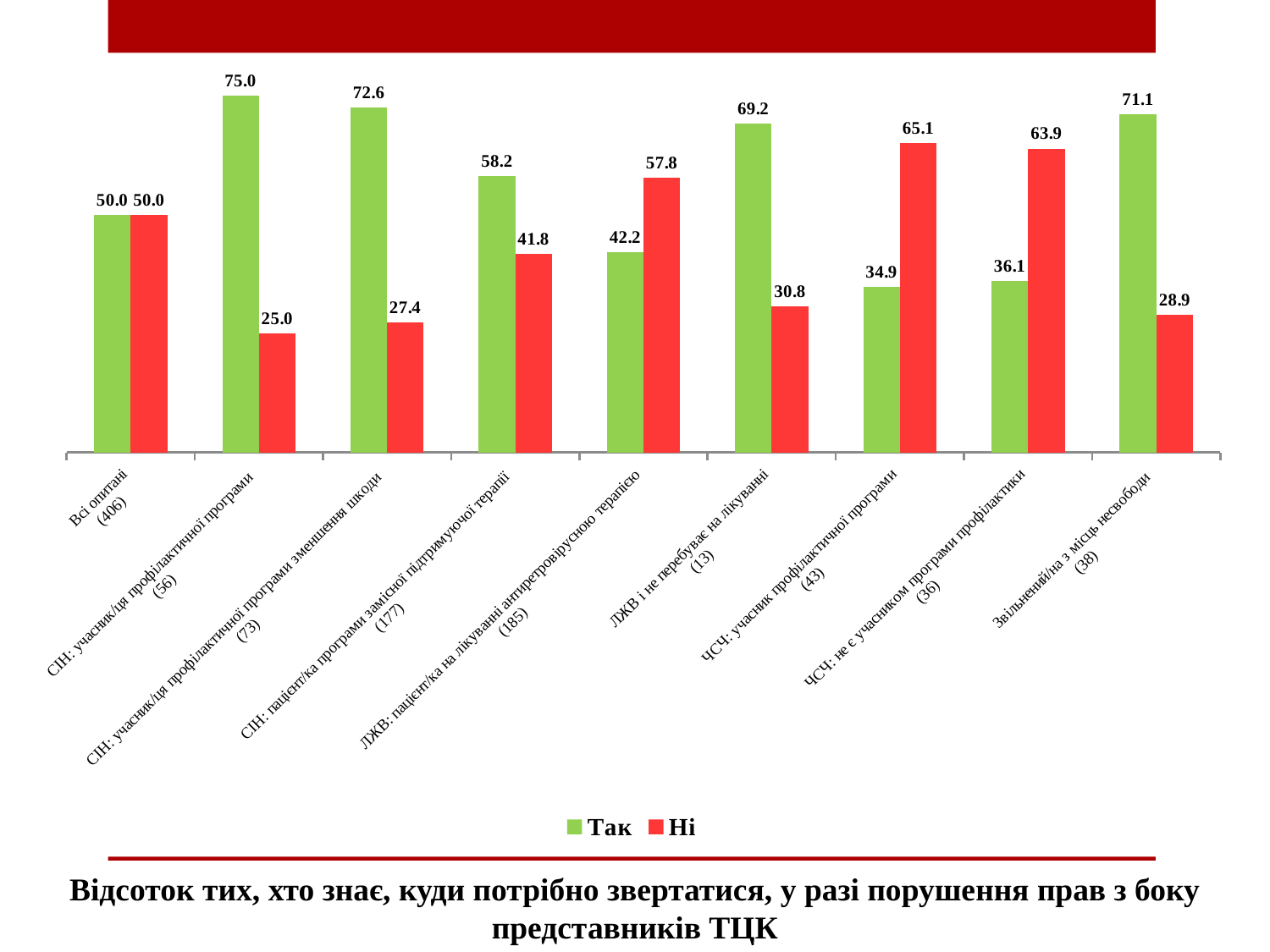
What is the value of "Ні" for "Всі опитані (406)"? 50.0 Which colour represents the "Ні" series in the legend? red What is the value of "Так" for "СІН: учасник/ця профілактичної програми (56)"? 75.0 Which category has the lowest value for "Так"? ЧСЧ: учасник профілактичної програми (43) What type of chart is shown on the slide? bar chart How many categories are shown on the x axis? 9 How many series does the legend list? 2 What is the value of "Так" for "Звільнений/на з місць несвободи (38)"? 71.1 What is the difference between "Так" and "Ні" for "СІН: пацієнт/ка програми замісної підтримуючої терапії (177)"? 16.4 For "ЛЖВ: пацієнт/ка на лікуванні антиретровірусною терапією (185)", which is larger, "Так" or "Ні"? Ні Which category has the highest value for "Так"? СІН: учасник/ця профілактичної програми (56) What is the value of "Ні" for "ЧСЧ: учасник профілактичної програми (43)"? 65.1